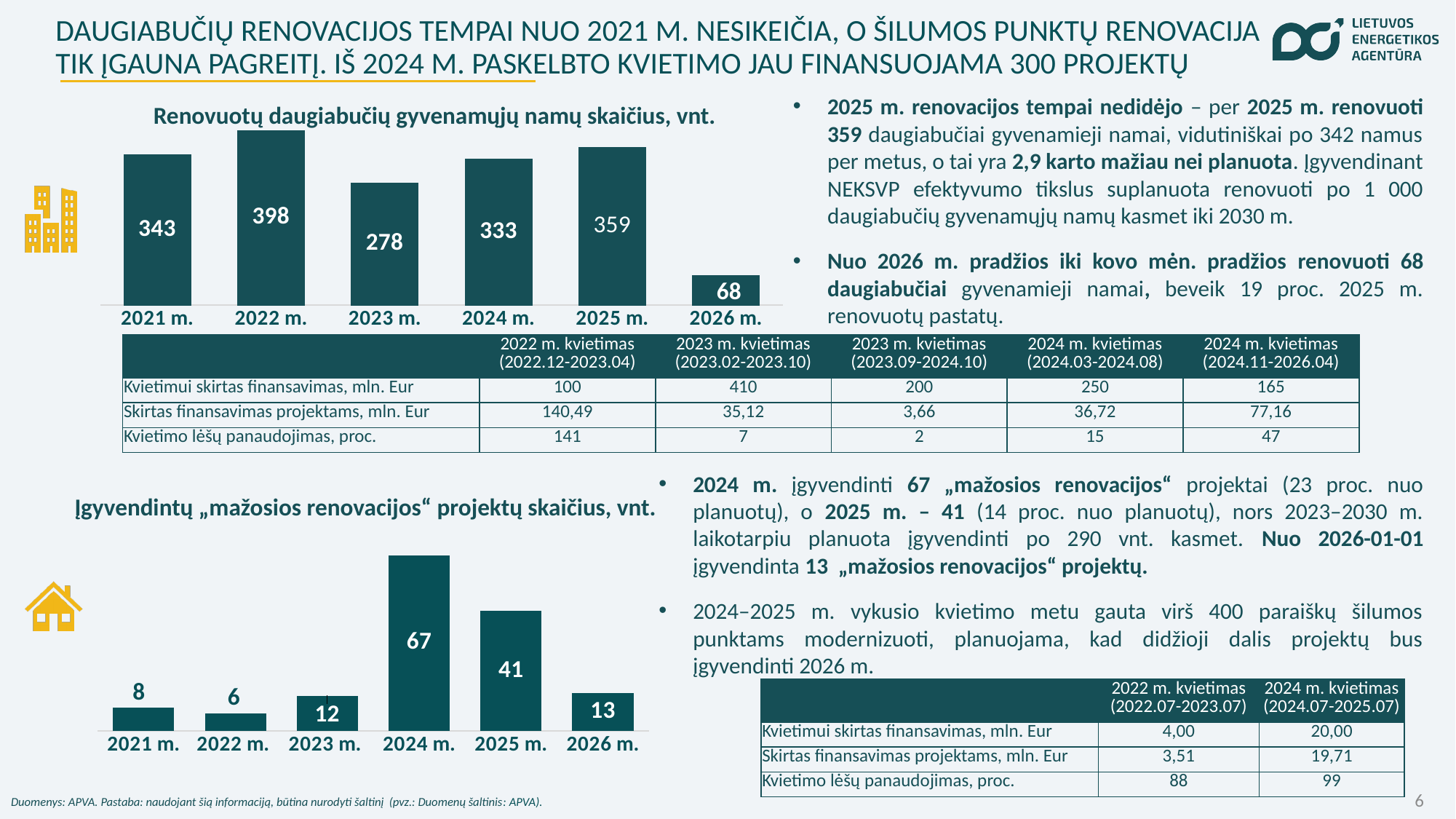
In the chart "Įgyvendintų „mažosios renovacijos“ projektų skaičius, vnt.", what is the value for 2022 m.? 6 In the chart "Renovuotų daugiabučių gyvenamųjų namų skaičius, vnt.", which year has the highest value? 2022 m. In the chart "Renovuotų daugiabučių gyvenamųjų namų skaičius, vnt.", how many years are shown? 6 In the chart "Renovuotų daugiabučių gyvenamųjų namų skaičius, vnt.", what is the difference between the values for 2022 m. and 2023 m.? 120 What type of chart is "Renovuotų daugiabučių gyvenamųjų namų skaičius, vnt."? Bar chart In the chart "Renovuotų daugiabučių gyvenamųjų namų skaičius, vnt.", which year has the lowest value? 2026 m. In the chart "Renovuotų daugiabučių gyvenamųjų namų skaičius, vnt.", what is the value for 2025 m.? 359 In the chart "Įgyvendintų „mažosios renovacijos“ projektų skaičius, vnt.", what is the difference between the values for 2024 m. and 2025 m.? 26 In the chart "Įgyvendintų „mažosios renovacijos“ projektų skaičius, vnt.", which year has the lowest value? 2022 m. In the chart "Įgyvendintų „mažosios renovacijos“ projektų skaičius, vnt.", what is the value for 2024 m.? 67 In the chart "Renovuotų daugiabučių gyvenamųjų namų skaičius, vnt.", what is the value for 2022 m.? 398 In the chart "Įgyvendintų „mažosios renovacijos“ projektų skaičius, vnt.", which is larger, the value for 2025 m. or 2026 m.? 2025 m.